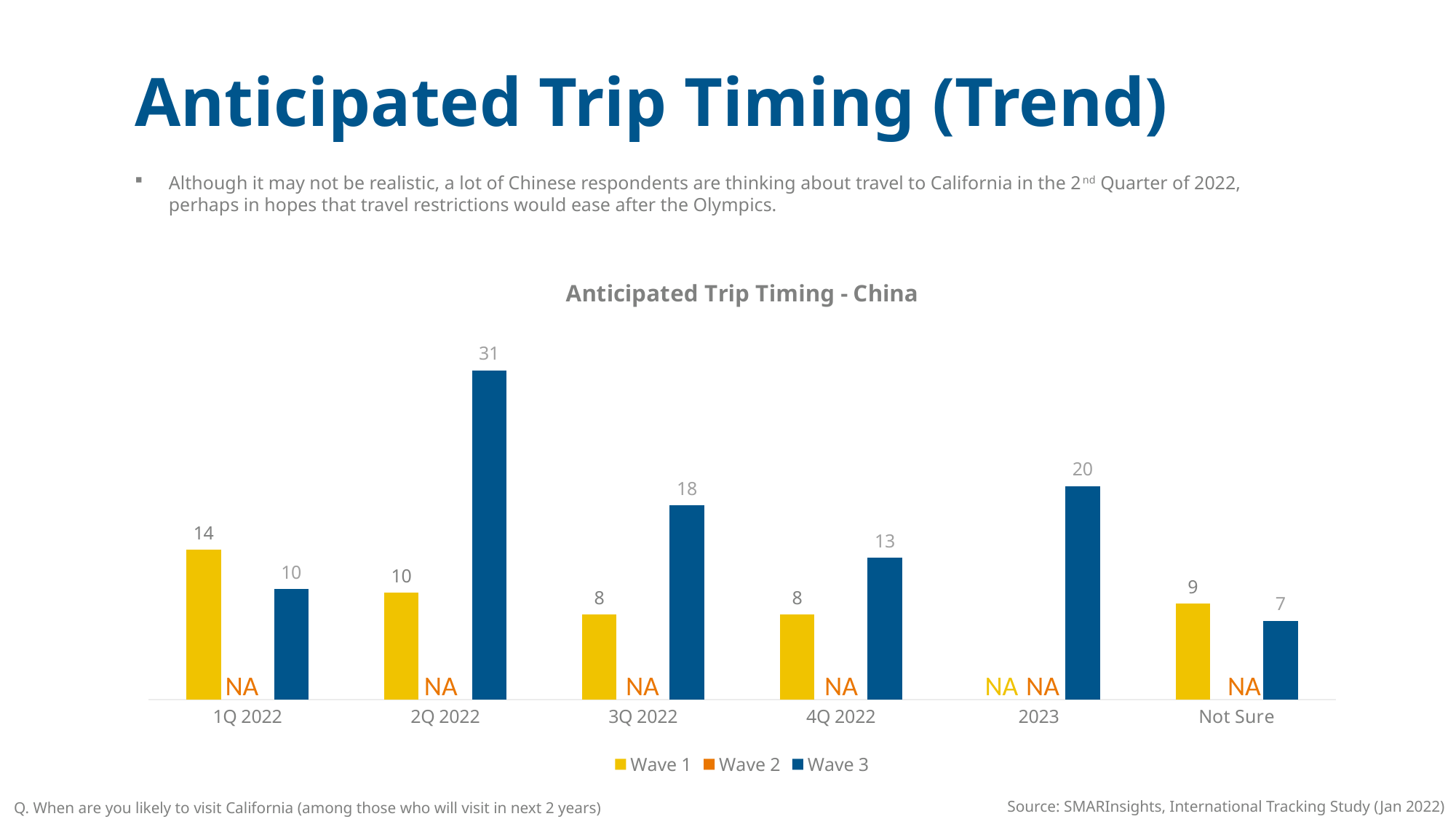
What is the Wave 3 value for Not Sure? 7 What kind of chart is shown on the slide? Bar chart Which is larger for 3Q 2022, the Wave 1 value or the Wave 3 value? Wave 3 What is the title of the chart? Anticipated Trip Timing - China How many categories are shown on the x axis? 6 What is the Wave 1 value for 1Q 2022? 14 What is the difference between the Wave 3 and Wave 1 values for 2Q 2022? 21 Which category has the lowest Wave 3 value? Not Sure Which category has the highest Wave 3 value? 2Q 2022 What is the Wave 3 value for 2Q 2022? 31 What value is shown for Wave 2 in every category? NA How many series does the legend list? 3